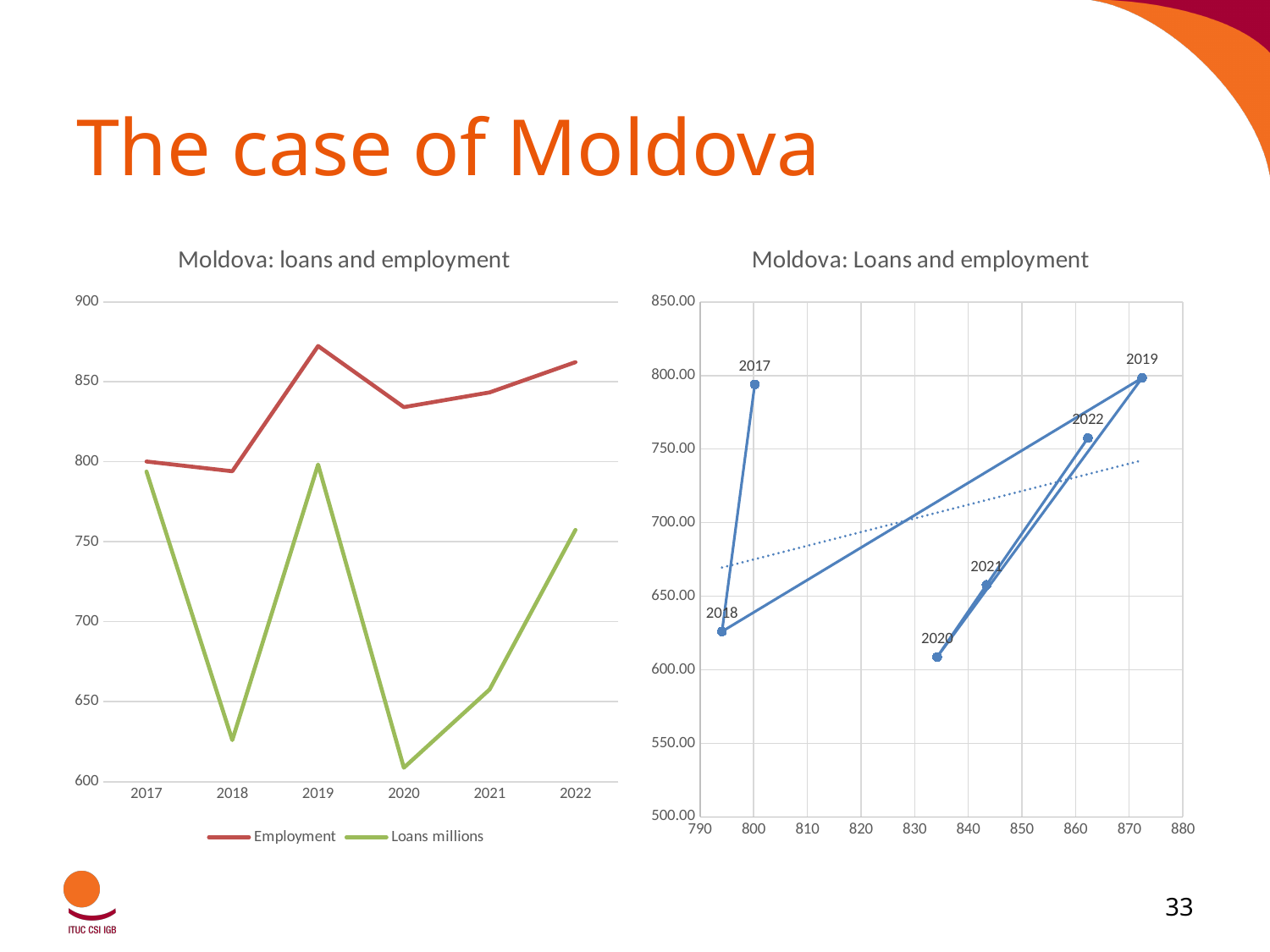
In the right chart titled 'Moldova: Loans and employment', which year's point has the lowest vertical-axis value? 2020 In the left chart titled 'Moldova: loans and employment', is the Employment value for 2019 greater or less than 850? greater In the left chart titled 'Moldova: loans and employment', what are the two legend entries? Employment and Loans millions In the left chart titled 'Moldova: loans and employment', which year has the larger Employment value, 2020 or 2022? 2022 In the left chart titled 'Moldova: loans and employment', is the Loans millions value for 2022 greater or less than 700? greater In the left chart titled 'Moldova: loans and employment', which year has the highest Employment value? 2019 In the left chart titled 'Moldova: loans and employment', is the Loans millions value for 2018 greater or less than 650? less In the left chart titled 'Moldova: loans and employment', how many years are shown on the x axis? 6 In the left chart titled 'Moldova: loans and employment', which year has the lowest Loans millions value? 2020 In the left chart titled 'Moldova: loans and employment', what kind of chart is it? line chart In the right chart titled 'Moldova: Loans and employment', which year's point has the highest vertical-axis value? 2019 In the left chart titled 'Moldova: loans and employment', how many series does the legend list? 2